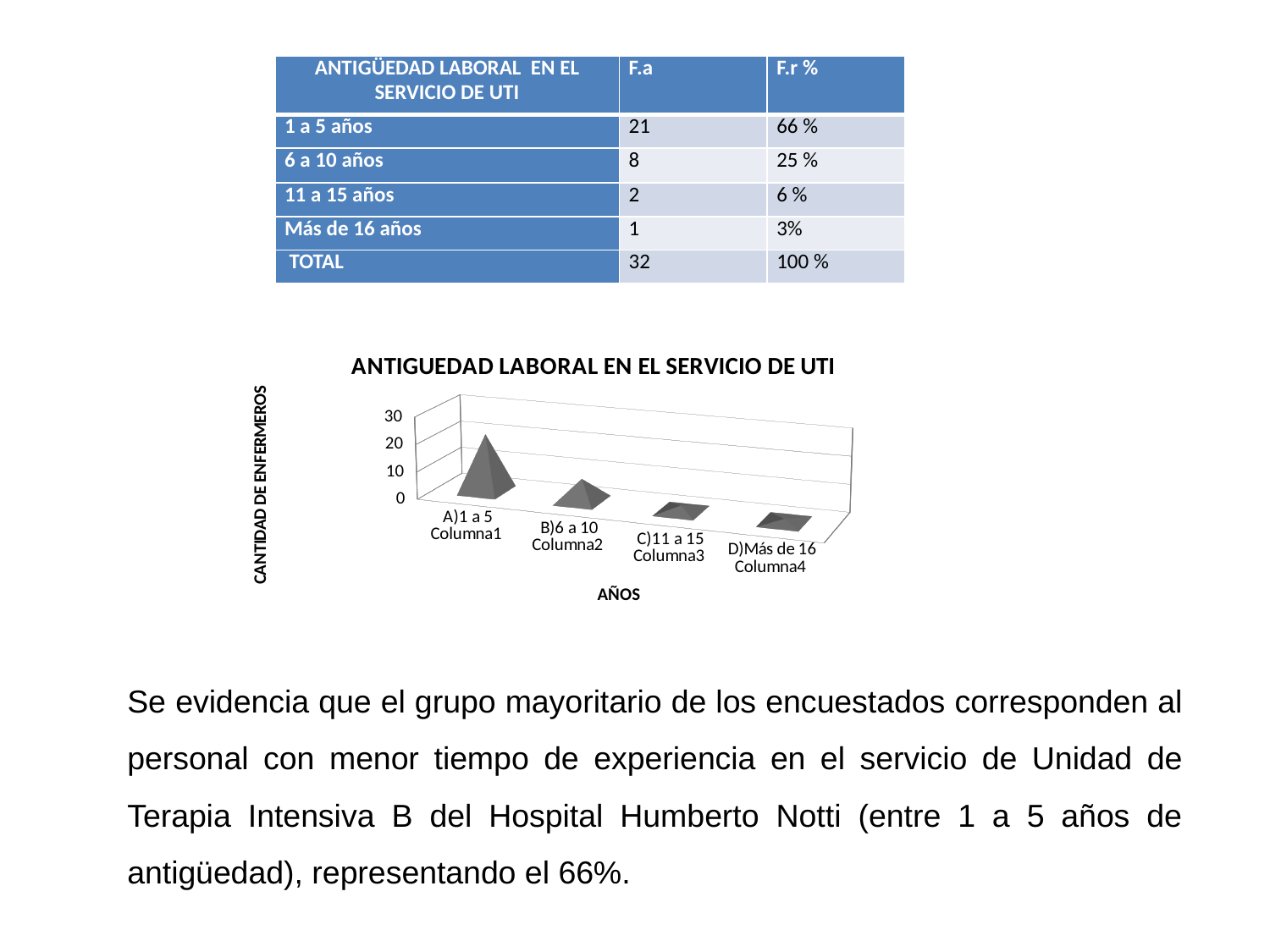
According to the table, what is the F.a value for '1 a 5 años'? 21 Is the value for A)1 a 5 in the chart greater or less than 10? greater Do the bar heights rise or fall from left to right along the x axis of the chart? Fall According to the table, what is the difference in F.a between '1 a 5 años' and '6 a 10 años'? 13 Which category has the tallest bar in the chart? A)1 a 5 Is the value for C)11 a 15 in the chart greater or less than 10? less Is the value for B)6 a 10 in the chart greater or less than 20? less Which is larger in the chart, the bar for B)6 a 10 or the bar for D)Más de 16? B)6 a 10 What kind of chart is shown under the title 'ANTIGUEDAD LABORAL EN EL SERVICIO DE UTI'? Bar chart Which category has the shortest bar in the chart? D)Más de 16 What is the label of the vertical axis of the chart? CANTIDAD DE ENFERMEROS How many categories are plotted along the x axis of the chart? 4